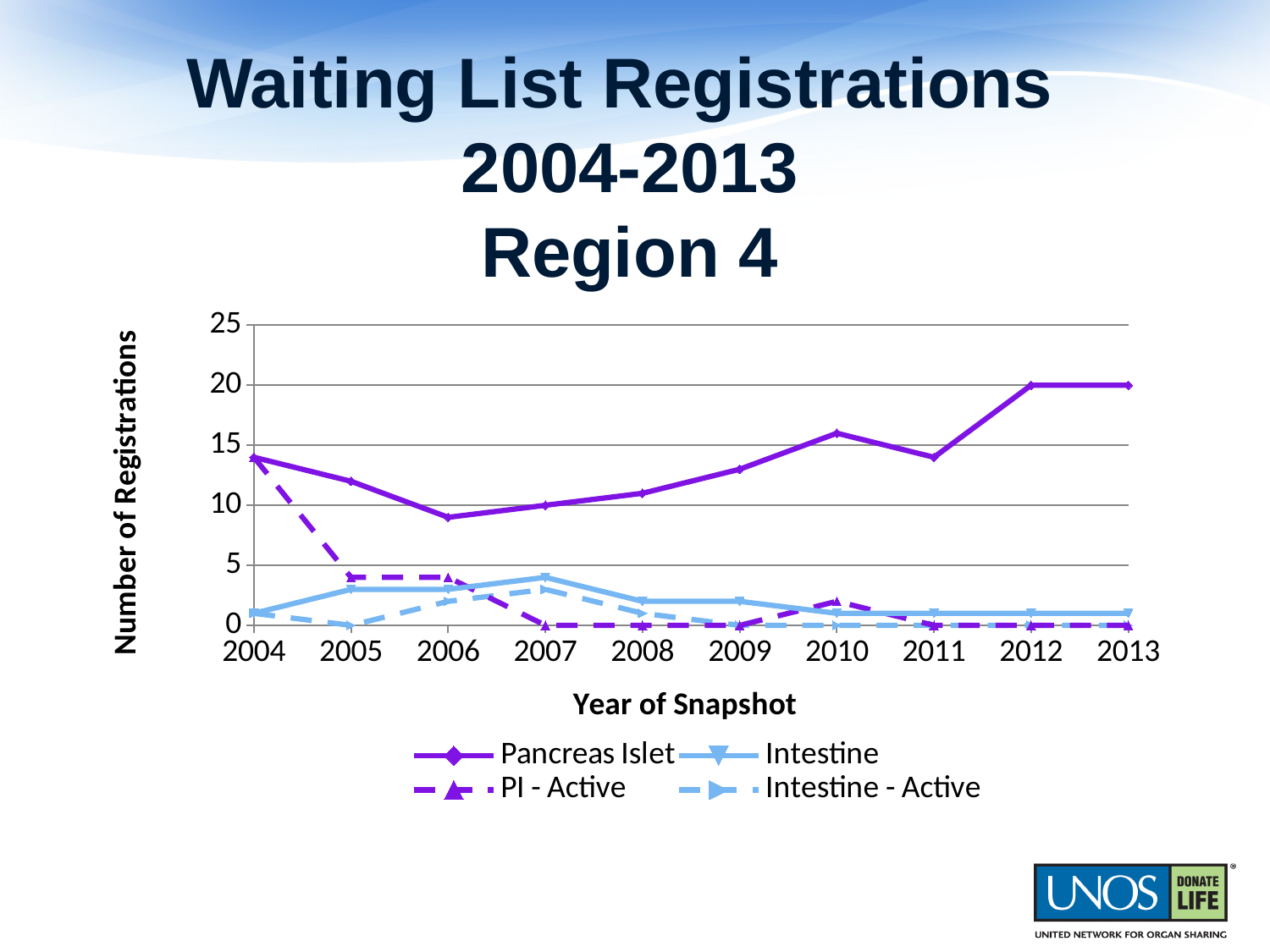
Is the value for Pancreas Islet in 2004 greater or less than 10? greater What kind of chart is shown on the slide? line chart What is the value for Pancreas Islet in 2012? 20 What is the value for Pancreas Islet in 2007? 10 Does the Pancreas Islet series rise or fall from 2007 to 2012? rise How many series does the legend list? 4 What is the title of the x axis? Year of Snapshot Is the value for Pancreas Islet in 2010 greater or less than 15? greater What is the value for PI - Active in 2008? 0 Is the value for Intestine in 2007 greater or less than 5? less How many years are plotted along the x axis? 10 Which is larger for Pancreas Islet: the value in 2004 or the value in 2005? 2004